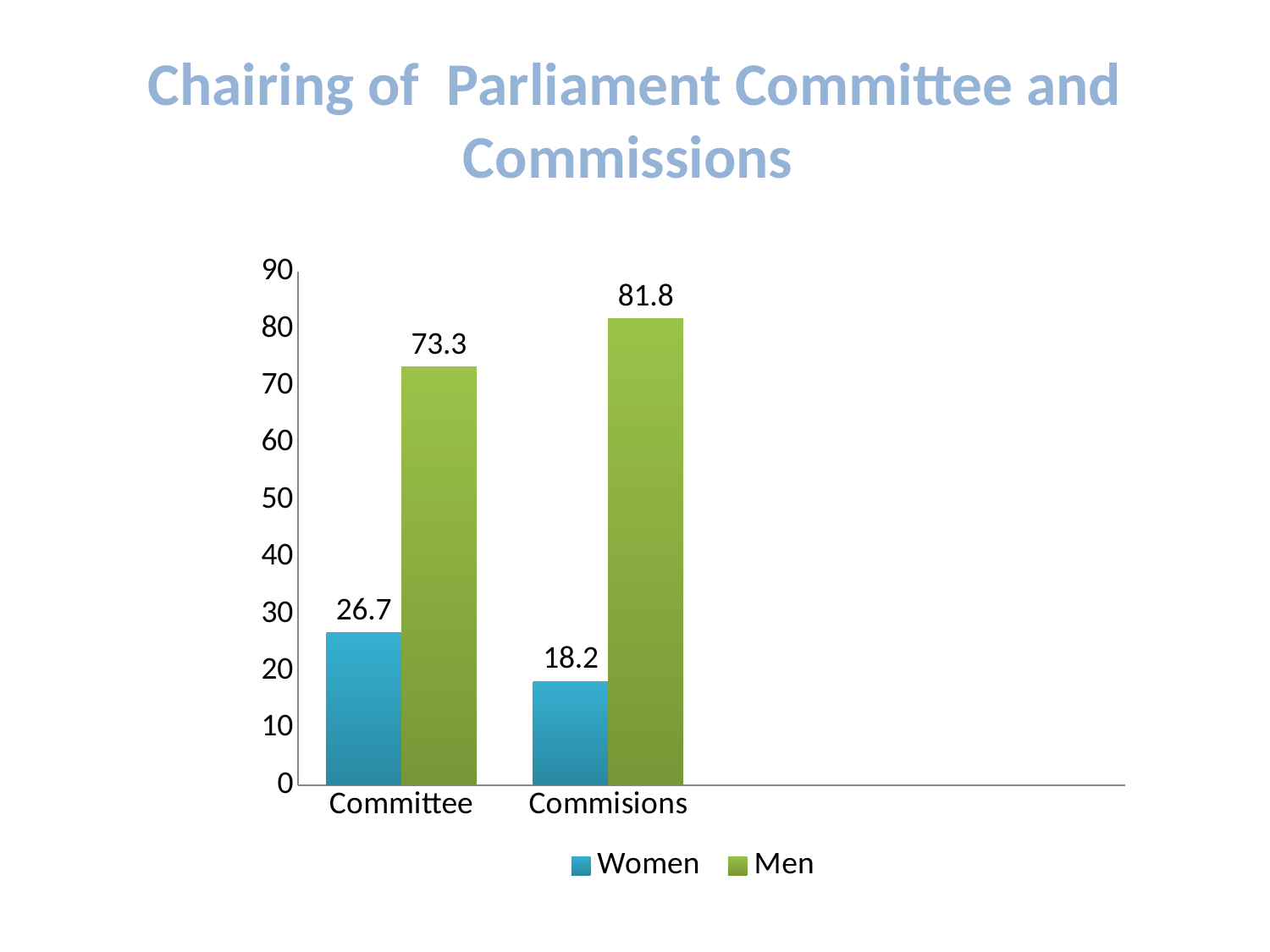
How many series does the legend list? 2 How many categories are shown on the x axis? 2 What is the difference between the Men and Women values in the Committee category? 46.6 What kind of chart is shown on the slide? bar chart Is the value for Men in the Commisions category greater or less than 80? greater What is the value for Men in the Commisions category? 81.8 Which category has the lowest value for Women? Commisions Which category has the highest value for Men? Commisions What is the value for Women in the Commisions category? 18.2 What is the value for Women in the Committee category? 26.7 Which is larger: the Women value for Committee or the Women value for Commisions? Committee What is the value for Men in the Committee category? 73.3